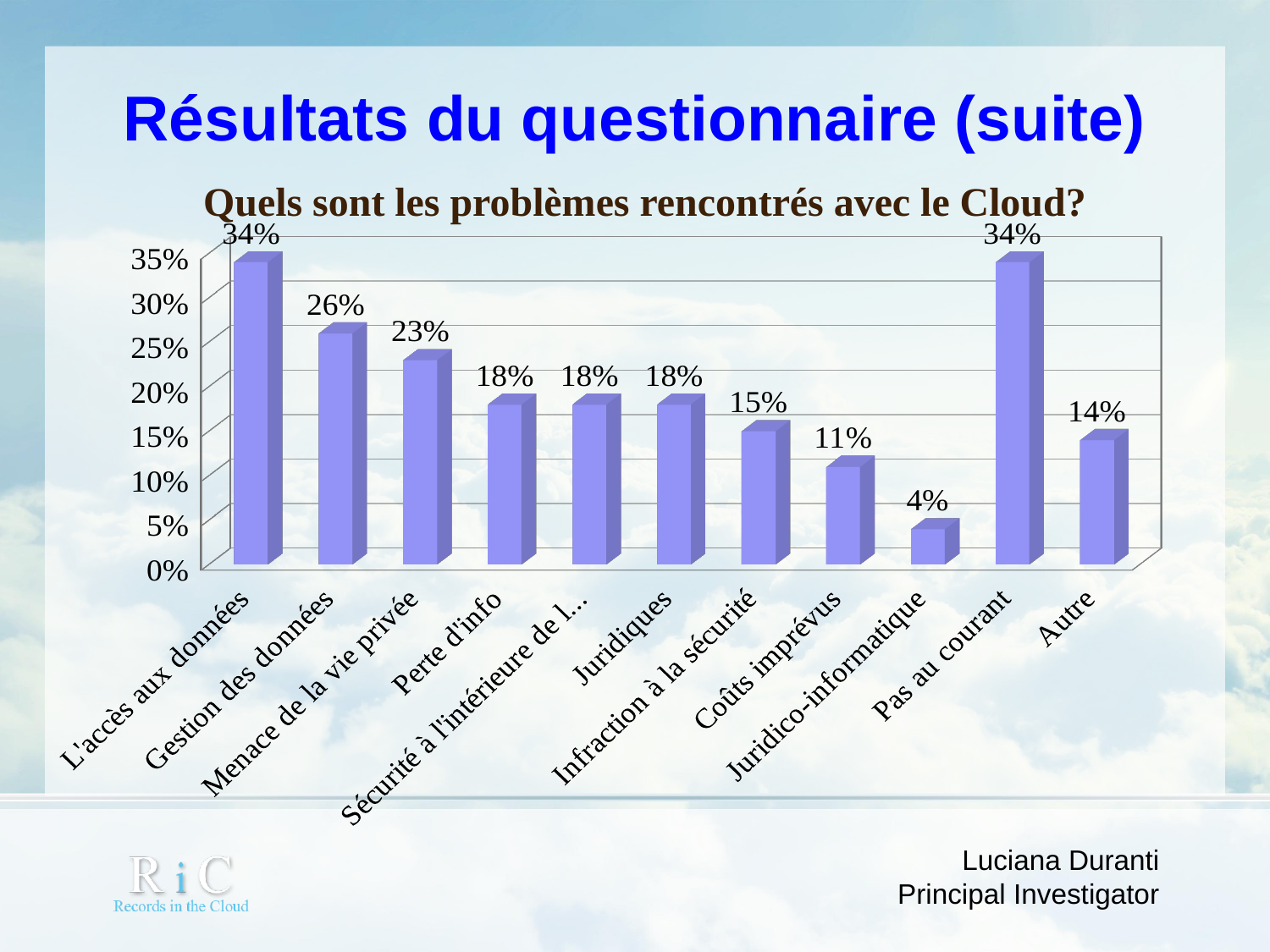
Which category has the lowest value? Juridico-informatique What is the difference between the values for L'accès aux données and Infraction à la sécurité? 19% What kind of chart is shown on the slide? Bar chart Which is larger, the value for Perte d'info or the value for Coûts imprévus? Perte d'info How many categories are shown in the chart? 11 What is the value for Coûts imprévus? 11% What is the value for Menace de la vie privée? 23% What is the value for Pas au courant? 34% What is the value for Gestion des données? 26% What is the value for Autre? 14% What is the title of the chart? Quels sont les problèmes rencontrés avec le Cloud? What is the difference between the values for Gestion des données and Autre? 12%